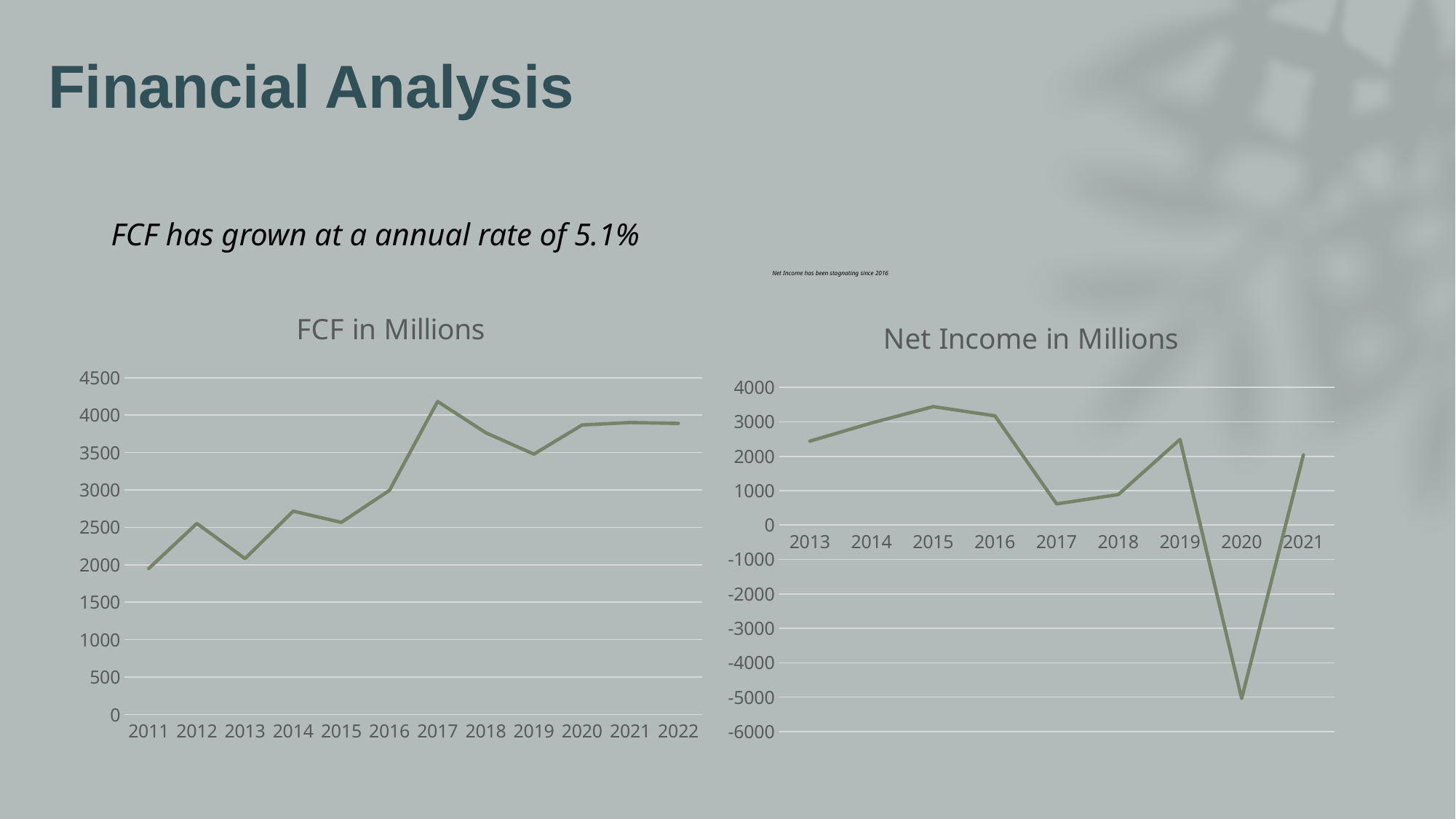
In the "FCF in Millions" chart, which is larger, the value for 2017 or the value for 2019? 2017 How many years are plotted on the "FCF in Millions" chart? 12 In the "FCF in Millions" chart, which year has the highest value? 2017 What kind of chart is the "FCF in Millions" chart? line chart In the "FCF in Millions" chart, is the value for 2017 greater or less than 4000? greater How many years are plotted on the "Net Income in Millions" chart? 9 In the "Net Income in Millions" chart, which year has the lowest value? 2020 In the "Net Income in Millions" chart, which year has the highest value? 2015 In the "Net Income in Millions" chart, is the value for 2017 greater or less than 1000? less What is the title of the chart on the right side of the slide? Net Income in Millions In the "Net Income in Millions" chart, is the value for 2020 greater or less than -4000? less